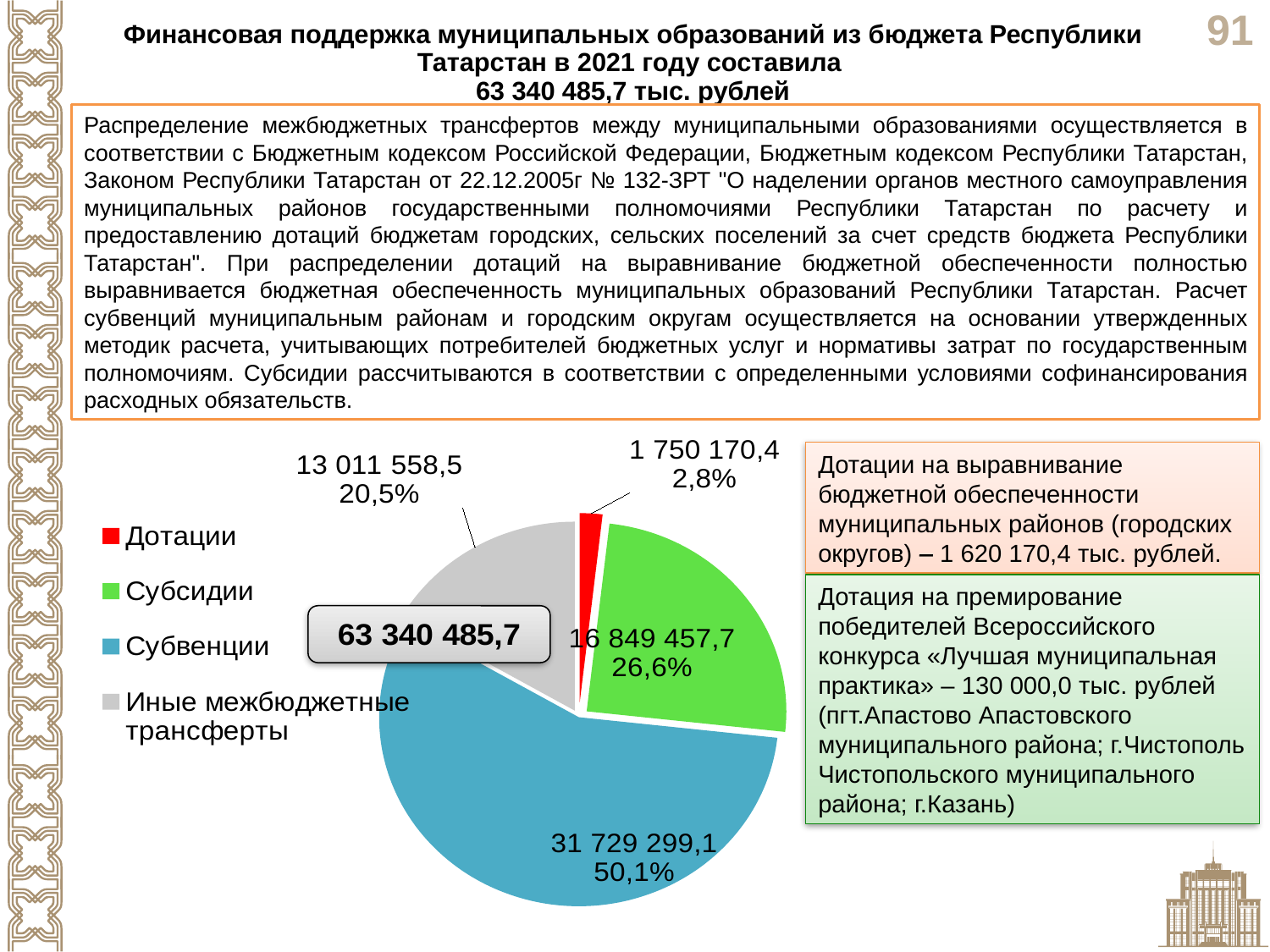
How many slices does the pie chart have? 4 What is the difference between the values for Субвенции and Субсидии in the pie chart? 14 879 841,4 What value is shown for Иные межбюджетные трансферты in the pie chart? 13 011 558,5 What percentage share is shown for Субсидии in the pie chart? 26,6% Which category has the largest slice in the pie chart? Субвенции What value is shown for Субвенции in the pie chart? 31 729 299,1 What kind of chart is shown on the slide? pie chart What percentage share is shown for Дотации in the pie chart? 2,8% Which category has the smallest slice in the pie chart? Дотации How many entries does the legend of the pie chart list? 4 Which is larger in the pie chart: Субсидии or Иные межбюджетные трансферты? Субсидии What total value is shown in the box next to the pie chart? 63 340 485,7